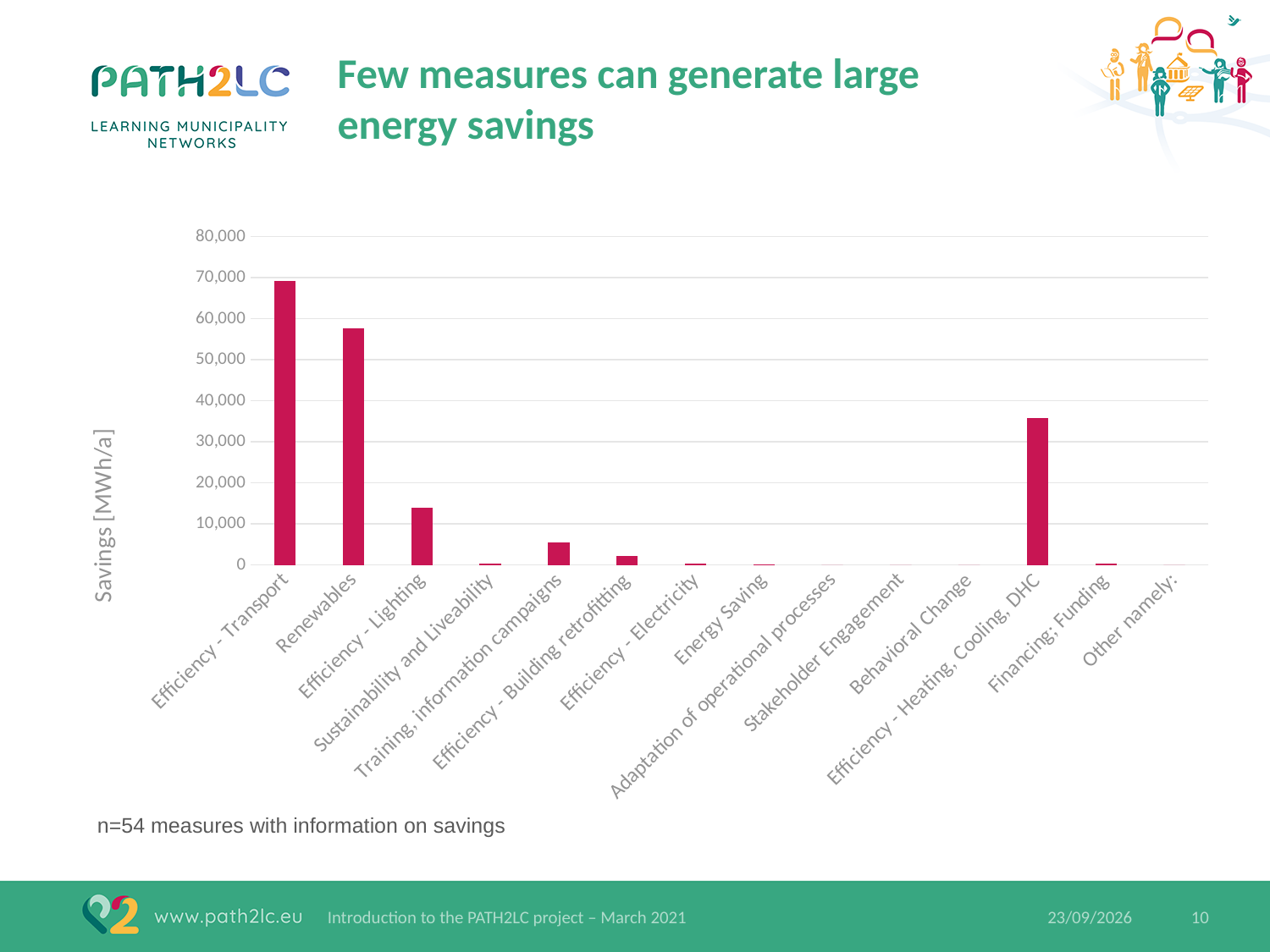
Is the value for Training, information campaigns greater or less than 10,000? less How many categories are shown on the x axis of the chart? 14 Is the value for Efficiency - Lighting greater or less than 20,000? less What kind of chart is shown on the slide? bar chart Which is larger, the savings for Efficiency - Lighting or for Training, information campaigns? Efficiency - Lighting Which is larger, the savings for Renewables or for Efficiency - Heating, Cooling, DHC? Renewables What is the label of the y axis of the chart? Savings [MWh/a] Which category has the highest savings in the chart? Efficiency - Transport Is the value for Renewables greater or less than 60,000? less What is the title of the slide containing the chart? Few measures can generate large energy savings